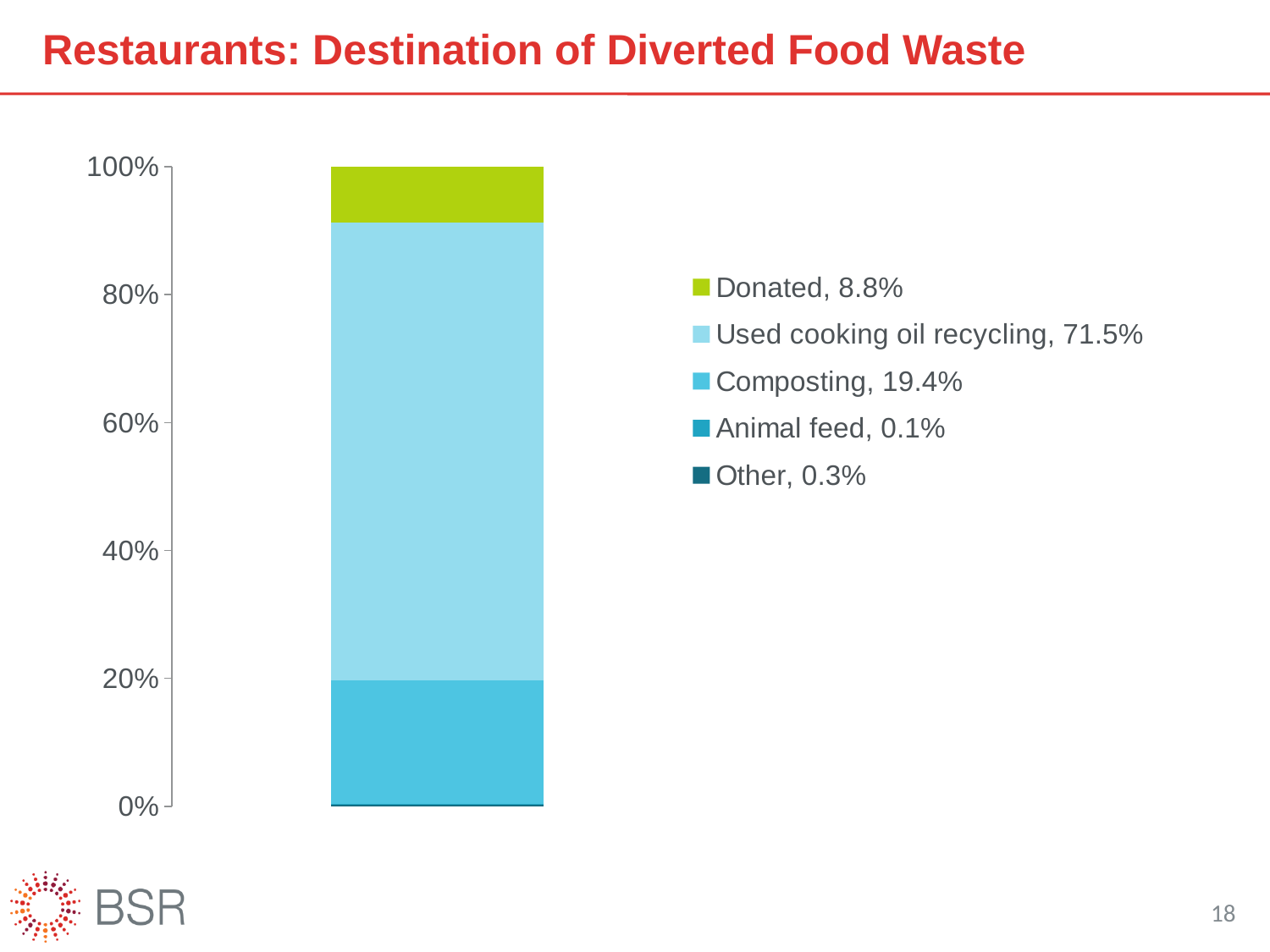
Which destination accounts for the largest share of diverted food waste? Used cooking oil recycling What share of diverted food waste is composted? 19.4% What share of diverted food waste is donated? 8.8% How many destination categories does the legend list? 5 What share of diverted food waste goes to used cooking oil recycling? 71.5% What share of diverted food waste goes to animal feed? 0.1% What is the difference in percentage points between used cooking oil recycling and composting? 52.1 Which is larger, the share for composting or the share for donated? Composting What kind of chart is shown on the slide? Stacked bar chart What is the title of the slide? Restaurants: Destination of Diverted Food Waste What colour represents the Donated segment in the chart? Green Which destination accounts for the smallest share of diverted food waste? Animal feed